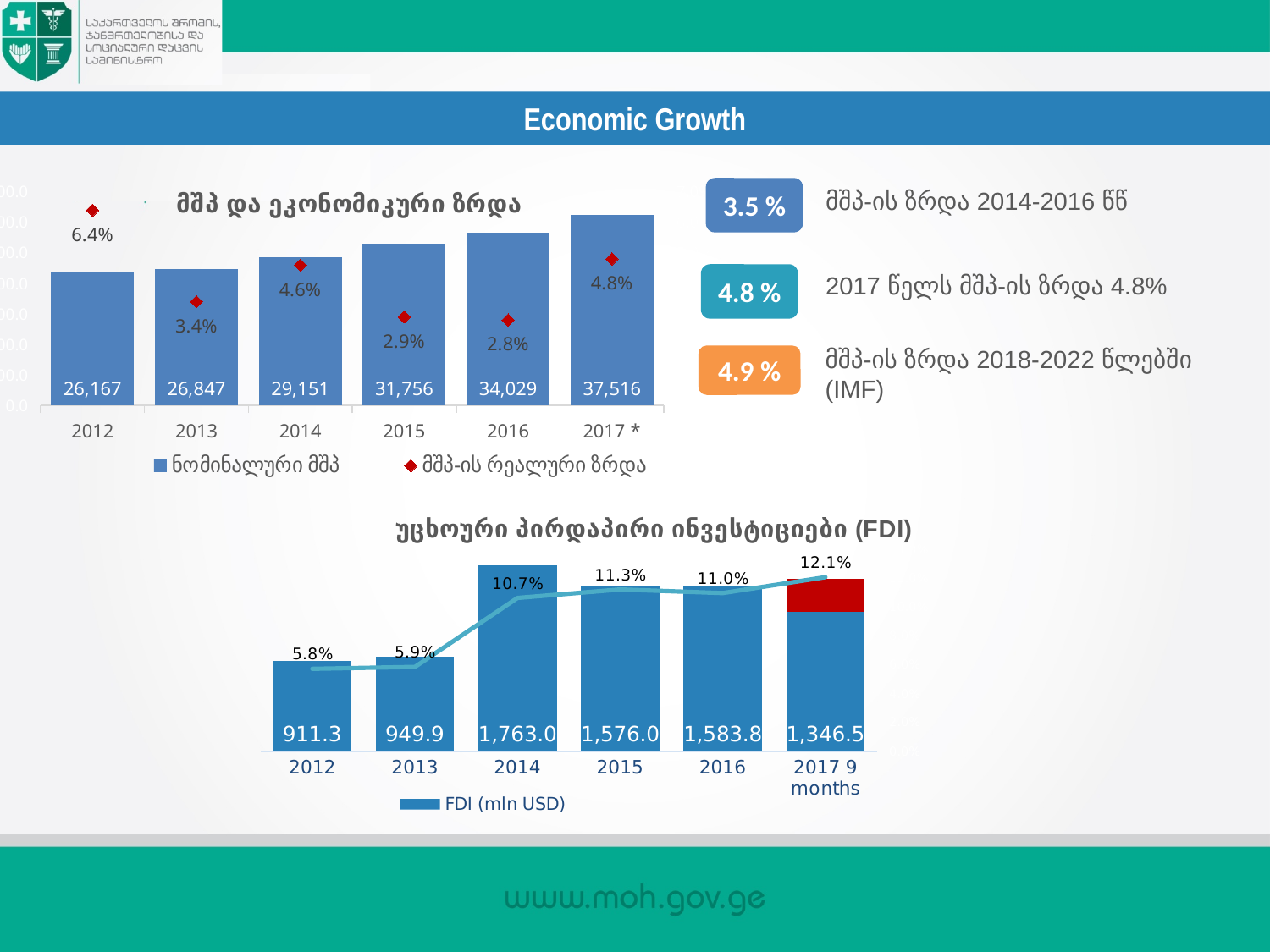
In the bottom FDI chart, is the FDI value for 2013 larger or smaller than the value for 2012? larger In the bottom FDI chart, what is the difference between the FDI values for 2016 and 2015? 7.8 In the bottom FDI chart, which year has the highest FDI value? 2014 In the top chart, what is the difference between the nominal GDP values for 2017 * and 2016? 3,487 In the top chart, do the nominal GDP bars rise or fall from 2012 to 2017 *? rise In the top chart, which year has the lowest real GDP growth rate? 2016 In the bottom FDI chart, what is the legend entry for the bars? FDI (mln USD) In the top chart, how many years are shown on the x axis? 6 In the top chart, what is the nominal GDP value shown for 2014? 29,151 In the bottom FDI chart, what percentage is shown for 2017 9 months? 12.1% In the bottom FDI chart, what is the FDI value for 2014? 1,763.0 In the top chart, what real GDP growth rate is shown for 2012? 6.4%